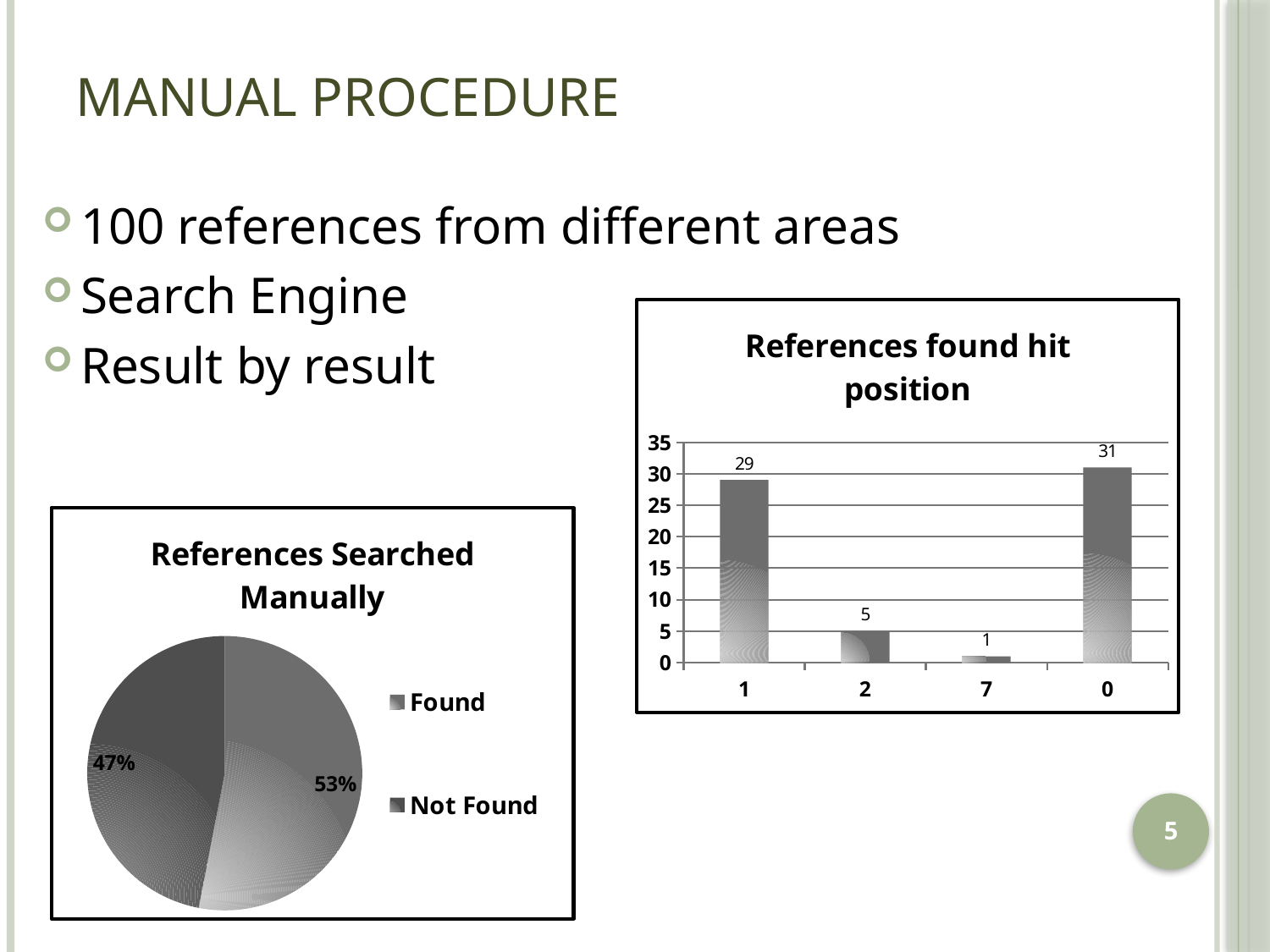
In the 'References found hit position' chart, what is the value for hit position 0? 31 In the 'References Searched Manually' pie chart, what share of references were Not Found? 47% In the 'References found hit position' chart, which hit position has the highest value? 0 In the 'References Searched Manually' pie chart, what share of references were Found? 53% In the 'References found hit position' chart, what is the value for hit position 1? 29 How many categories are shown on the x axis of the 'References found hit position' chart? 4 How many entries does the legend of the 'References Searched Manually' chart list? 2 In the 'References found hit position' chart, which hit position has the lowest value? 7 In the 'References found hit position' chart, what is the value for hit position 7? 1 In the 'References Searched Manually' pie chart, which slice is larger, Found or Not Found? Found What kind of chart is 'References Searched Manually'? Pie chart In the 'References found hit position' chart, what is the difference between the values for hit position 0 and hit position 1? 2